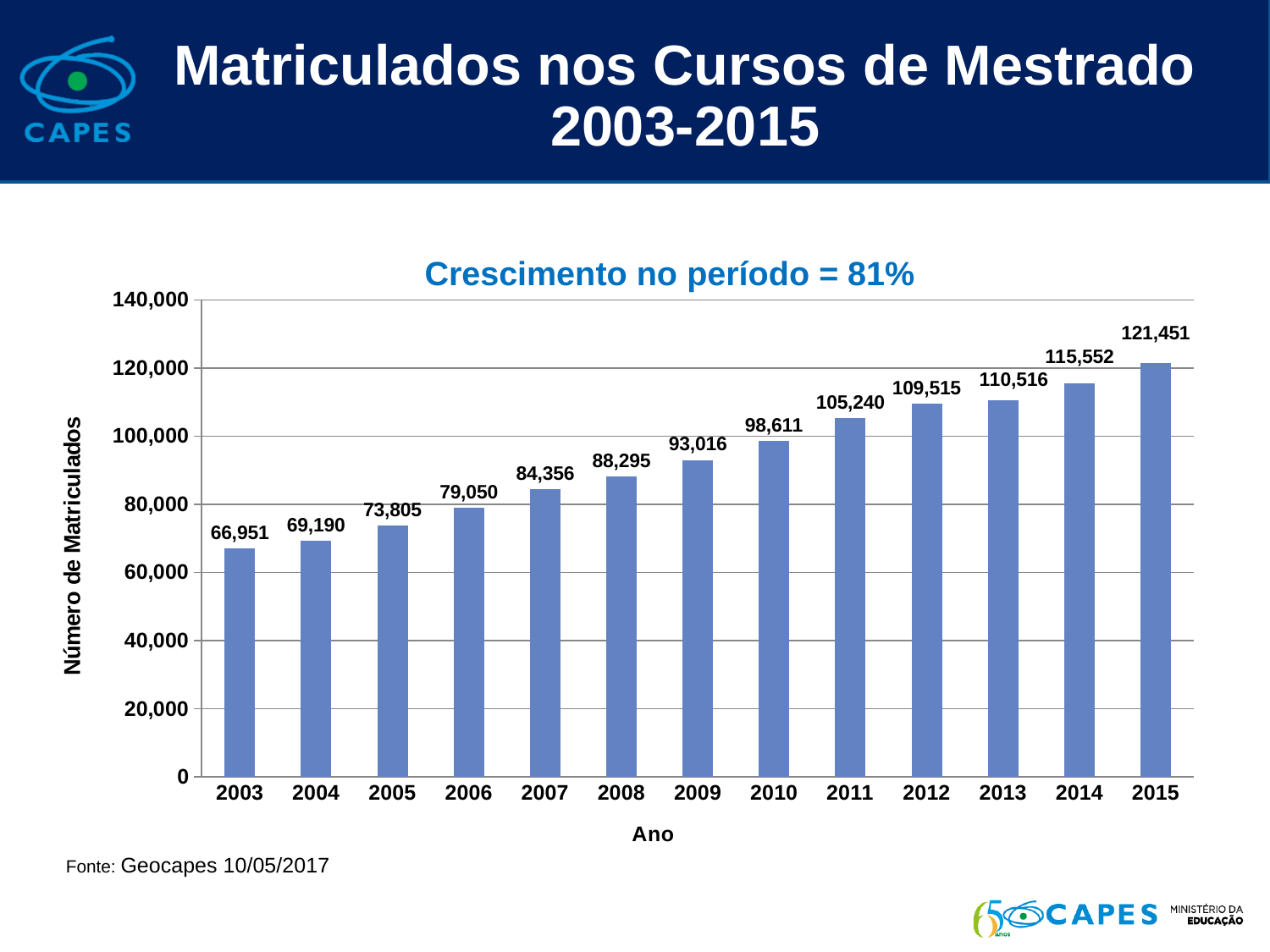
What is the number of matriculados in 2010? 98,611 What is the difference in matriculados between 2015 and 2003? 54,500 How many years are shown on the x axis? 13 What kind of chart is shown on the slide? Bar chart Is the value for 2011 greater or less than 100,000? greater What is the number of matriculados in 2015? 121,451 Which year has the highest number of matriculados? 2015 Do the values rise or fall from 2003 to 2015? Rise What is the number of matriculados in 2003? 66,951 Which year has more matriculados, 2006 or 2009? 2009 What is the difference in matriculados between 2008 and 2007? 3,939 Which year has the lowest number of matriculados? 2003